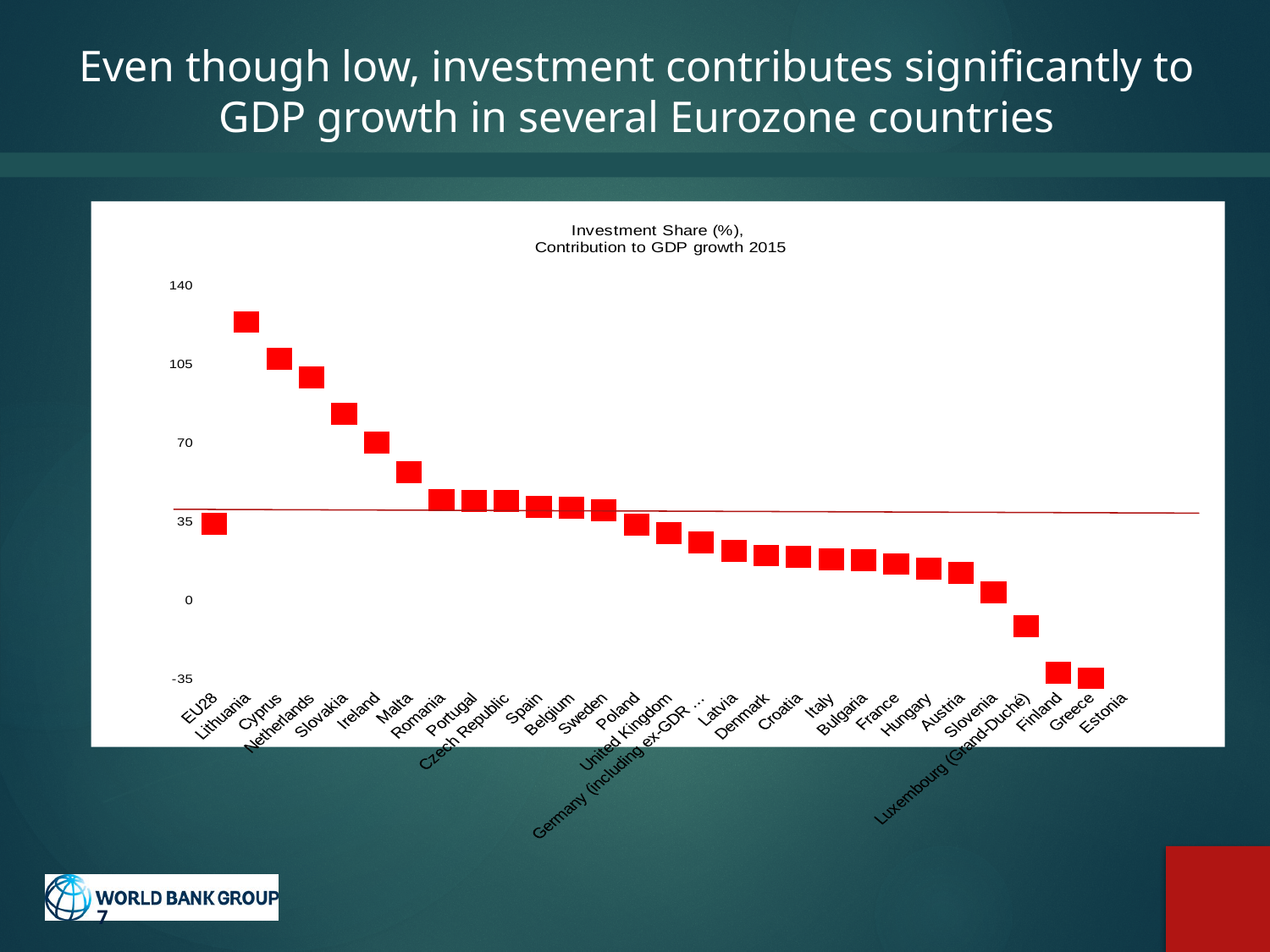
Which has a larger value, Finland or Greece? Finland Do the values rise or fall moving from left to right along the x axis? fall Which country has the highest investment share contribution in the chart? Lithuania Is the value for Italy greater or less than 35? less Is the value for Netherlands greater or less than 70? greater Is the value for Lithuania greater or less than 105? greater What kind of chart is shown on the slide? scatter chart What is the title of the chart? Investment Share (%), Contribution to GDP growth 2015 Which has a larger value, Lithuania or Cyprus? Lithuania